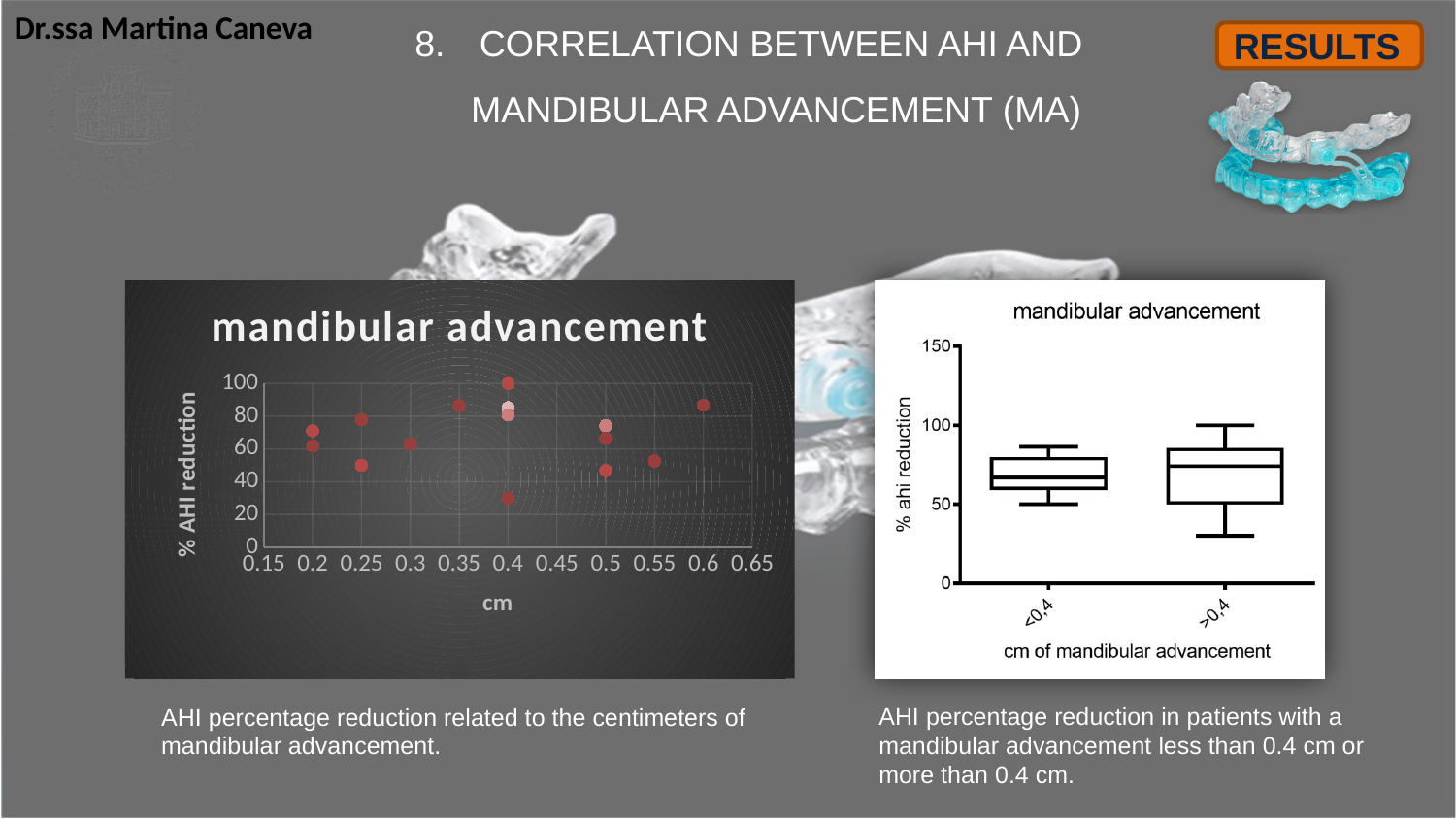
In the left scatter plot, is the value of the point at 0.6 cm greater or less than 80? greater In the left scatter plot, is the lowest point at 0.4 cm greater or less than 40? less In the right box plot, is the lower whisker of the ">0,4" group greater or less than 50? less In the left scatter plot, at which cm value does the highest point occur? 0.4 In the right box plot, how many categories are shown on the x axis? 2 In the right box plot, which group has the lower bottom whisker, "<0,4" or ">0,4"? >0,4 In the left scatter plot, what is the label of the y axis? % AHI reduction What kind of chart is the right chart titled "mandibular advancement"? box plot In the right box plot, what is the label of the x axis? cm of mandibular advancement What kind of chart is the left chart titled "mandibular advancement"? scatter plot